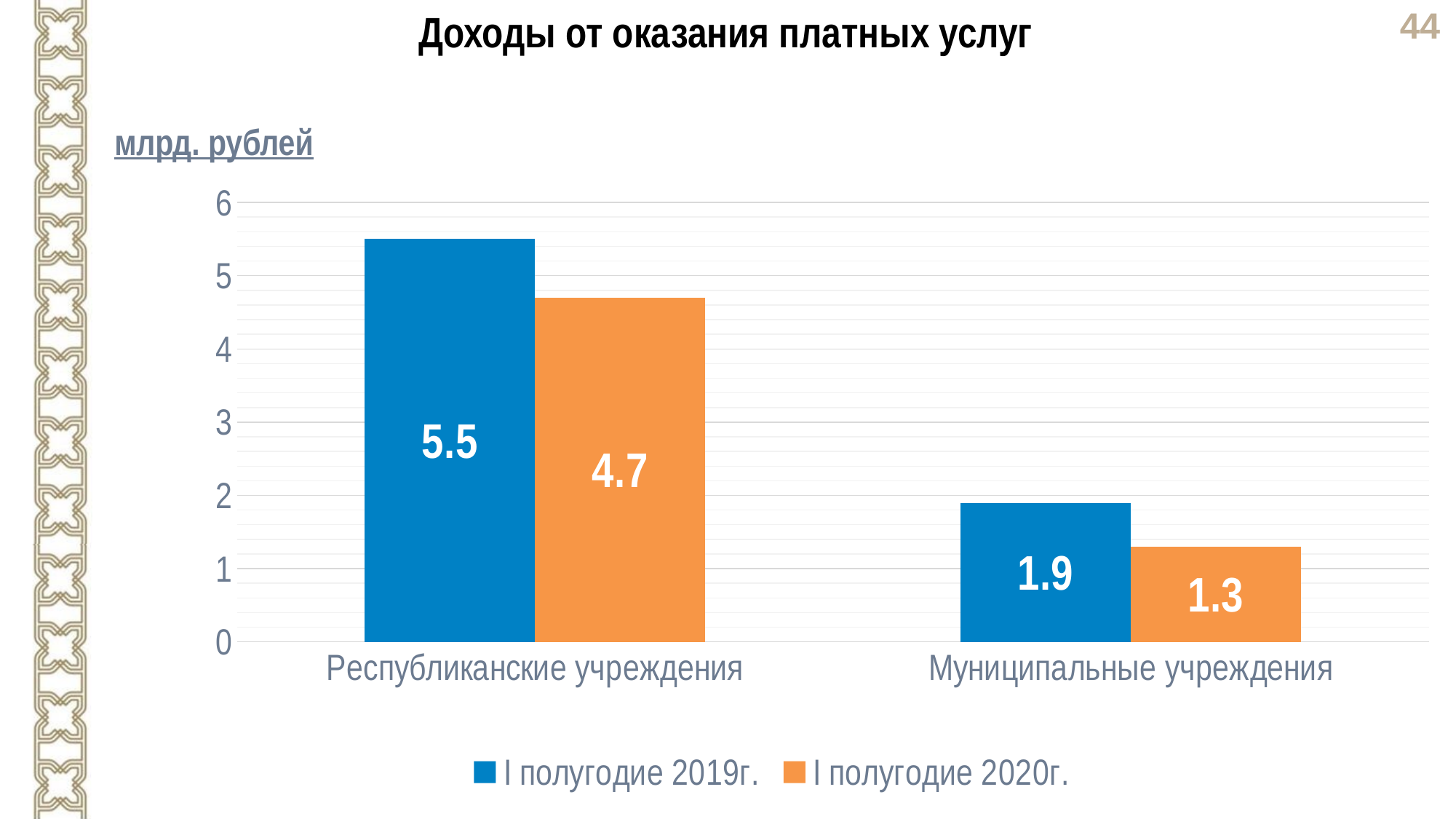
What is the value for Республиканские учреждения in I полугодие 2019г.? 5.5 How many categories are shown on the x axis? 2 Which category has the lowest value in I полугодие 2020г.? Муниципальные учреждения What is the value for Муниципальные учреждения in I полугодие 2019г.? 1.9 What is the difference between the I полугодие 2019г. and I полугодие 2020г. values for Республиканские учреждения? 0.8 How many series does the legend list? 2 What is the difference between the I полугодие 2019г. and I полугодие 2020г. values for Муниципальные учреждения? 0.6 Which is larger for Муниципальные учреждения: the I полугодие 2019г. value or the I полугодие 2020г. value? I полугодие 2019г. What kind of chart is shown on the slide? Bar chart Which category has the highest value in I полугодие 2019г.? Республиканские учреждения What is the value for Республиканские учреждения in I полугодие 2020г.? 4.7 What is the value for Муниципальные учреждения in I полугодие 2020г.? 1.3